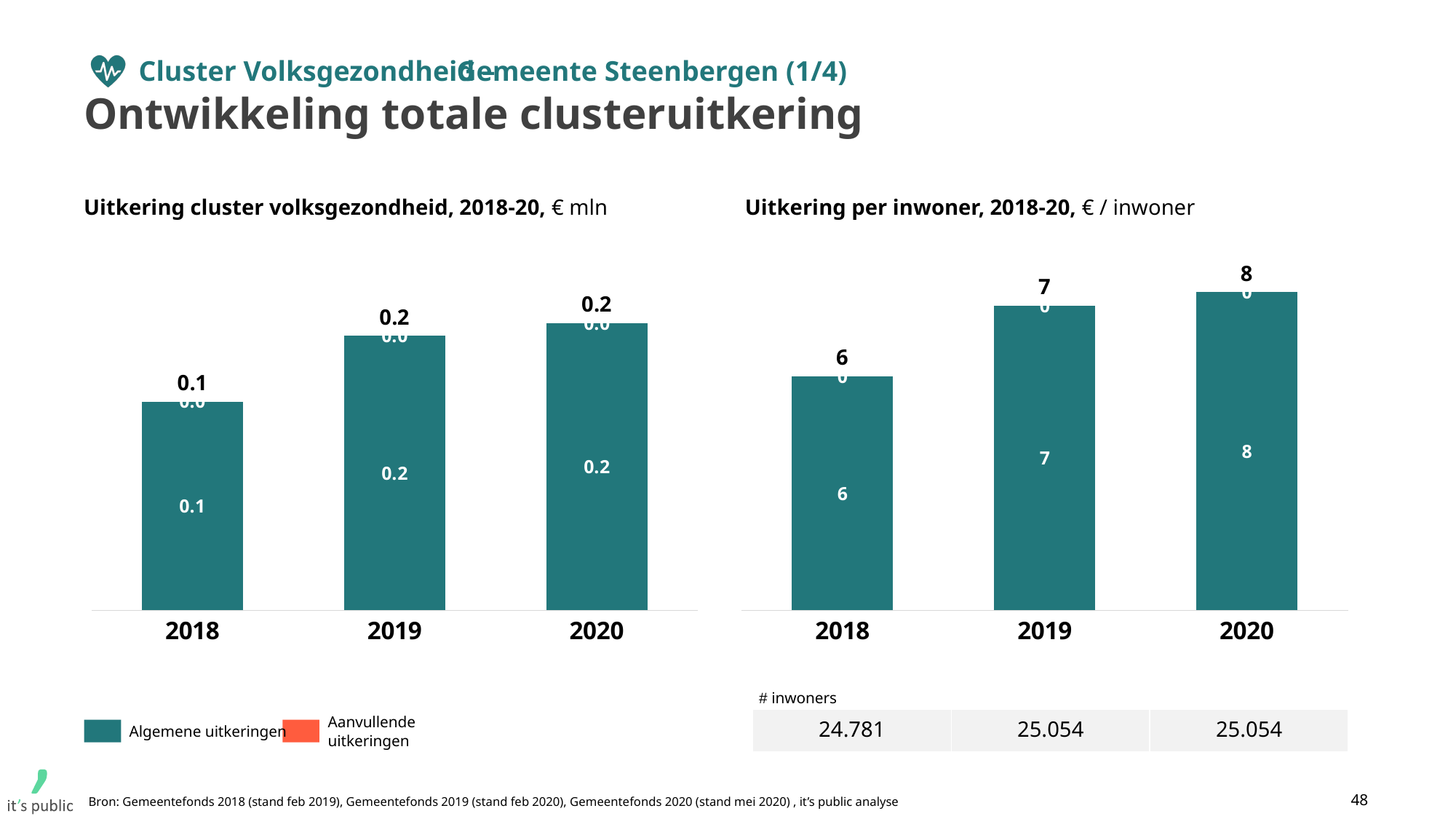
In the chart 'Uitkering cluster volksgezondheid, 2018-20', is the total value for 2020 larger or smaller than the total value for 2018? larger In the chart 'Uitkering cluster volksgezondheid, 2018-20', what is the total value for 2018? 0.1 In the chart 'Uitkering per inwoner, 2018-20', what is the difference between the total values for 2020 and 2018? 2 In the chart 'Uitkering per inwoner, 2018-20', which year has the lowest total value? 2018 In the chart 'Uitkering cluster volksgezondheid, 2018-20', what is the total value for 2019? 0.2 How many series does the legend on the slide list? 2 What kind of chart is 'Uitkering cluster volksgezondheid, 2018-20'? Stacked bar chart In the chart 'Uitkering per inwoner, 2018-20', do the total values rise or fall from 2018 to 2020? rise In the chart 'Uitkering per inwoner, 2018-20', what is the total value for 2020? 8 How many years are shown on the x axis of the chart 'Uitkering per inwoner, 2018-20'? 3 In the chart 'Uitkering per inwoner, 2018-20', what is the total value for 2018? 6 In the chart 'Uitkering per inwoner, 2018-20', which year has the highest total value? 2020